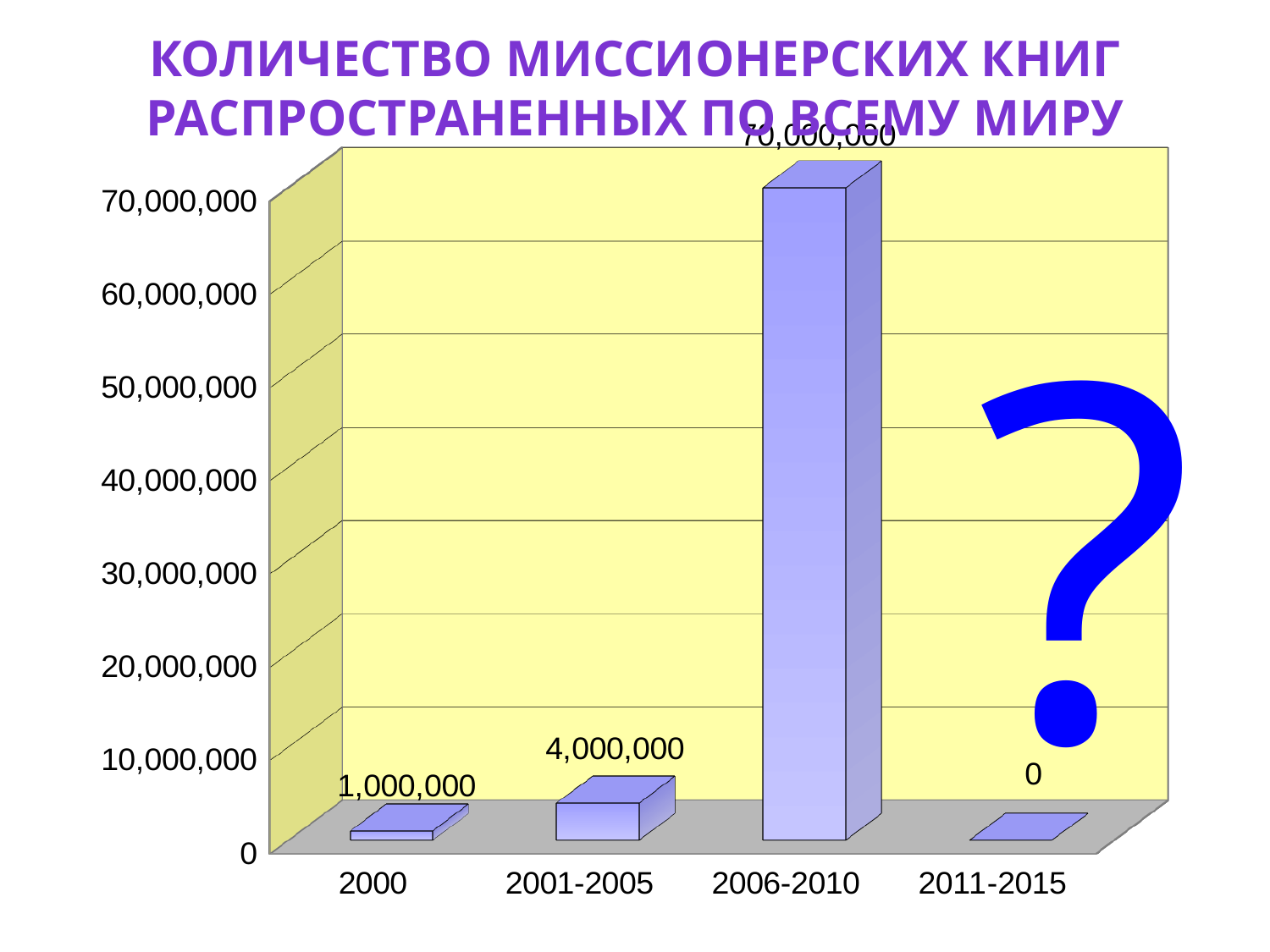
What is the value for 2006-2010? 70,000,000 What is the difference between the values for 2006-2010 and 2001-2005? 66,000,000 How many categories are shown on the x axis? 4 What is the title of the chart? КОЛИЧЕСТВО МИССИОНЕРСКИХ КНИГ РАСПРОСТРАНЕННЫХ ПО ВСЕМУ МИРУ What kind of chart is this? bar chart Which category has the highest value? 2006-2010 Which category has the lowest value? 2011-2015 Which is larger, the value for 2000 or the value for 2001-2005? 2001-2005 What is the value for 2011-2015? 0 What is the value for 2001-2005? 4,000,000 What is the value for 2000? 1,000,000 What is the difference between the values for 2001-2005 and 2000? 3,000,000